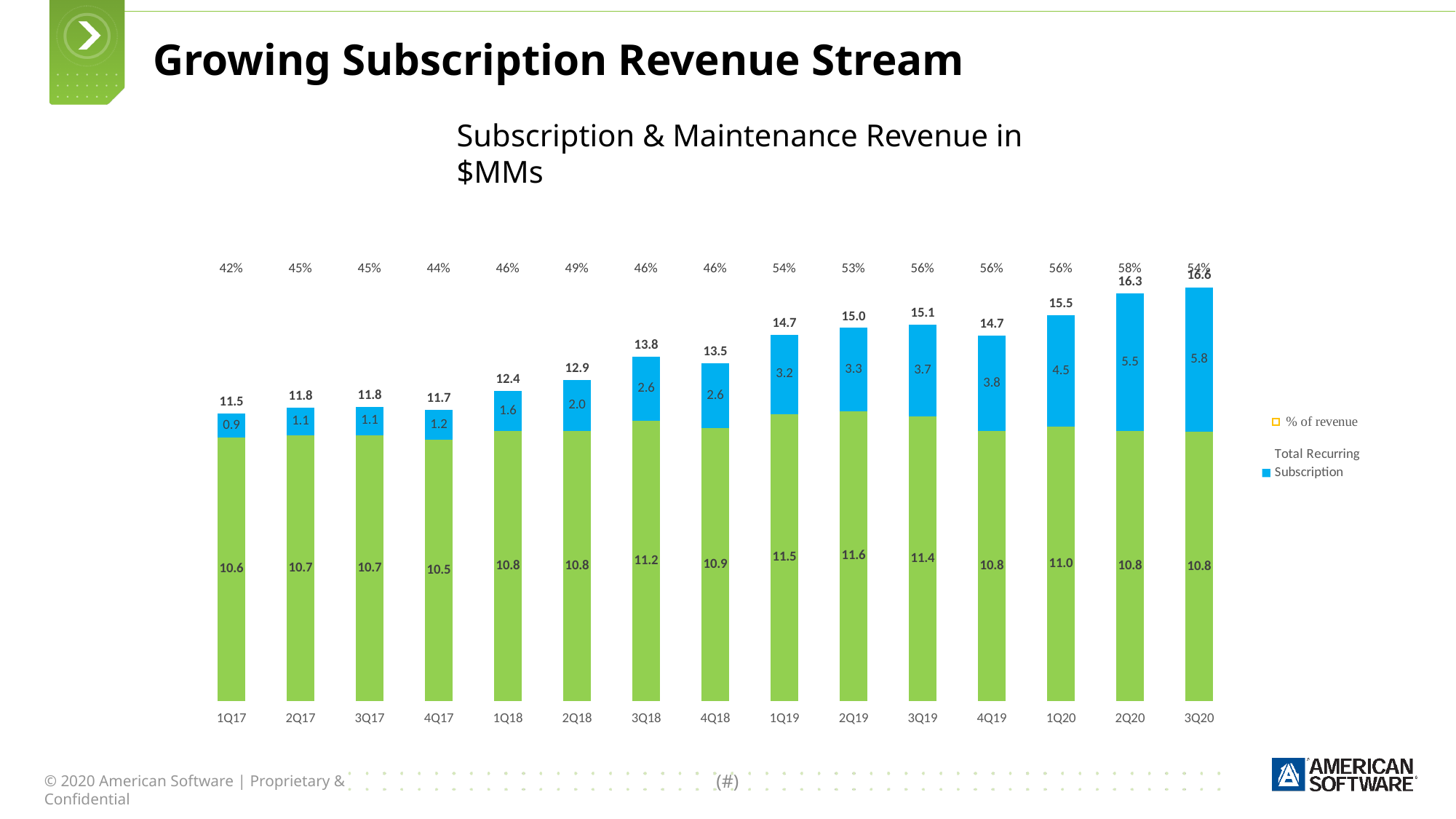
What is the Subscription value for 3Q20? 5.8 Which quarter has the highest Total Recurring value? 3Q20 What is the Total Recurring value shown above the bar for 1Q19? 14.7 What is the title of the chart? Subscription & Maintenance Revenue in $MMs What kind of chart is shown on the slide? Stacked bar chart What % of revenue figure is shown above the 2Q20 bar? 58% Does the Subscription value generally rise or fall from 1Q17 to 3Q20? Rise Which quarter has the lowest Subscription value? 1Q17 What is the value of the green (bottom) segment for 2Q19? 11.6 How many quarters are shown on the x axis? 15 What is the difference between the Subscription values for 3Q20 and 1Q17? 4.9 Which is larger, the Subscription value for 1Q20 or for 4Q19? 1Q20